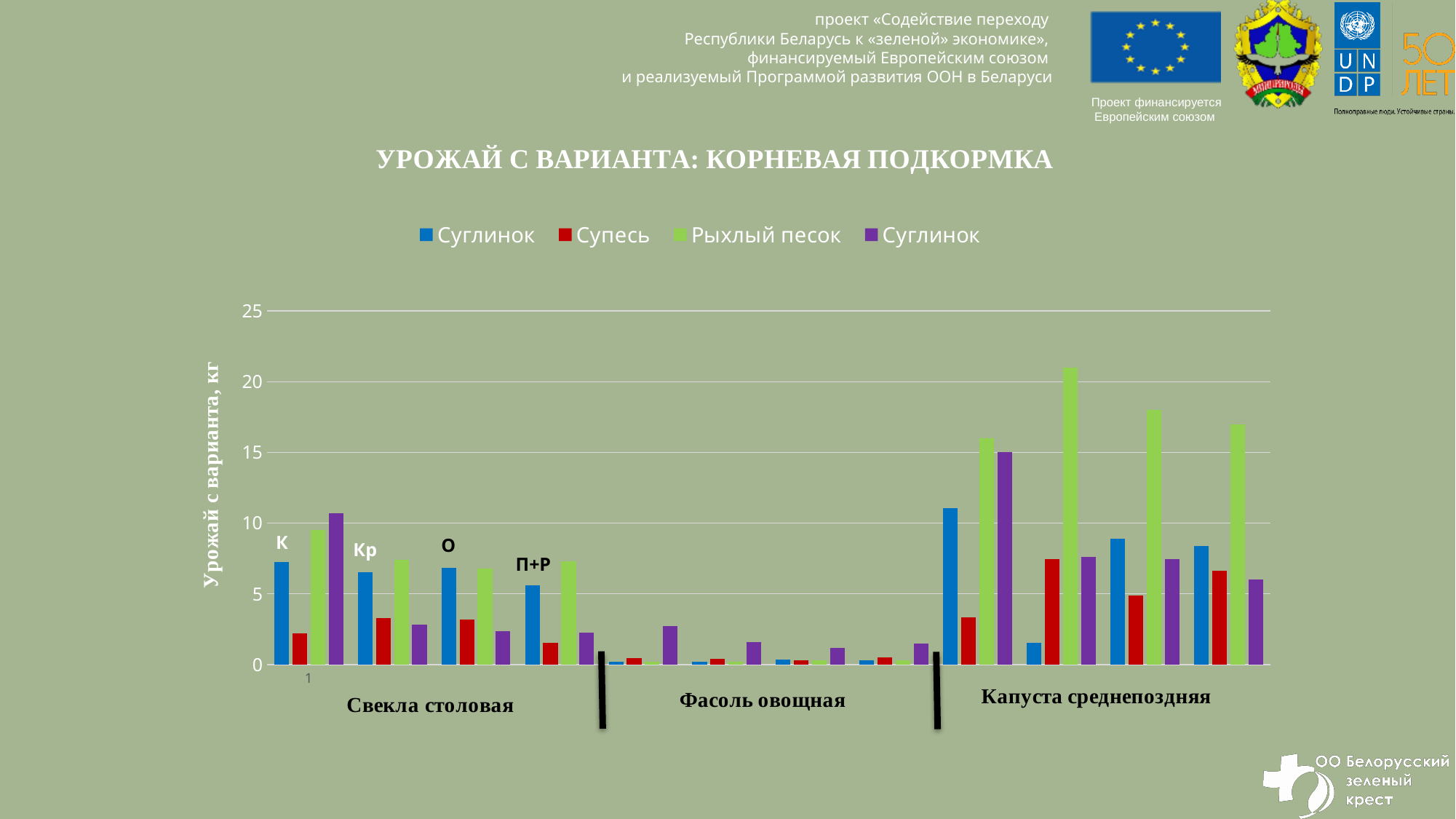
Which crop group has the lowest bars overall? Фасоль овощная How many crop groups are labelled along the bottom of the chart? 3 What is the label of the vertical axis? Урожай с варианта, кг How many series does the legend list? 4 What is the highest value shown on the vertical axis? 25 What kind of chart is shown on the slide? bar chart Are all the bars in the Фасоль овощная group greater or less than 5? less Is the tallest green (Рыхлый песок) bar in the Капуста среднепоздняя group greater or less than 20? greater In the Свекла столовая group, which is larger for variant К: the blue bar or the red bar? the blue bar What is the title of the chart? УРОЖАЙ С ВАРИАНТА: КОРНЕВАЯ ПОДКОРМКА Is the purple bar for variant К in the Свекла столовая group greater or less than 10? greater Which crop group contains the tallest bar in the chart? Капуста среднепоздняя